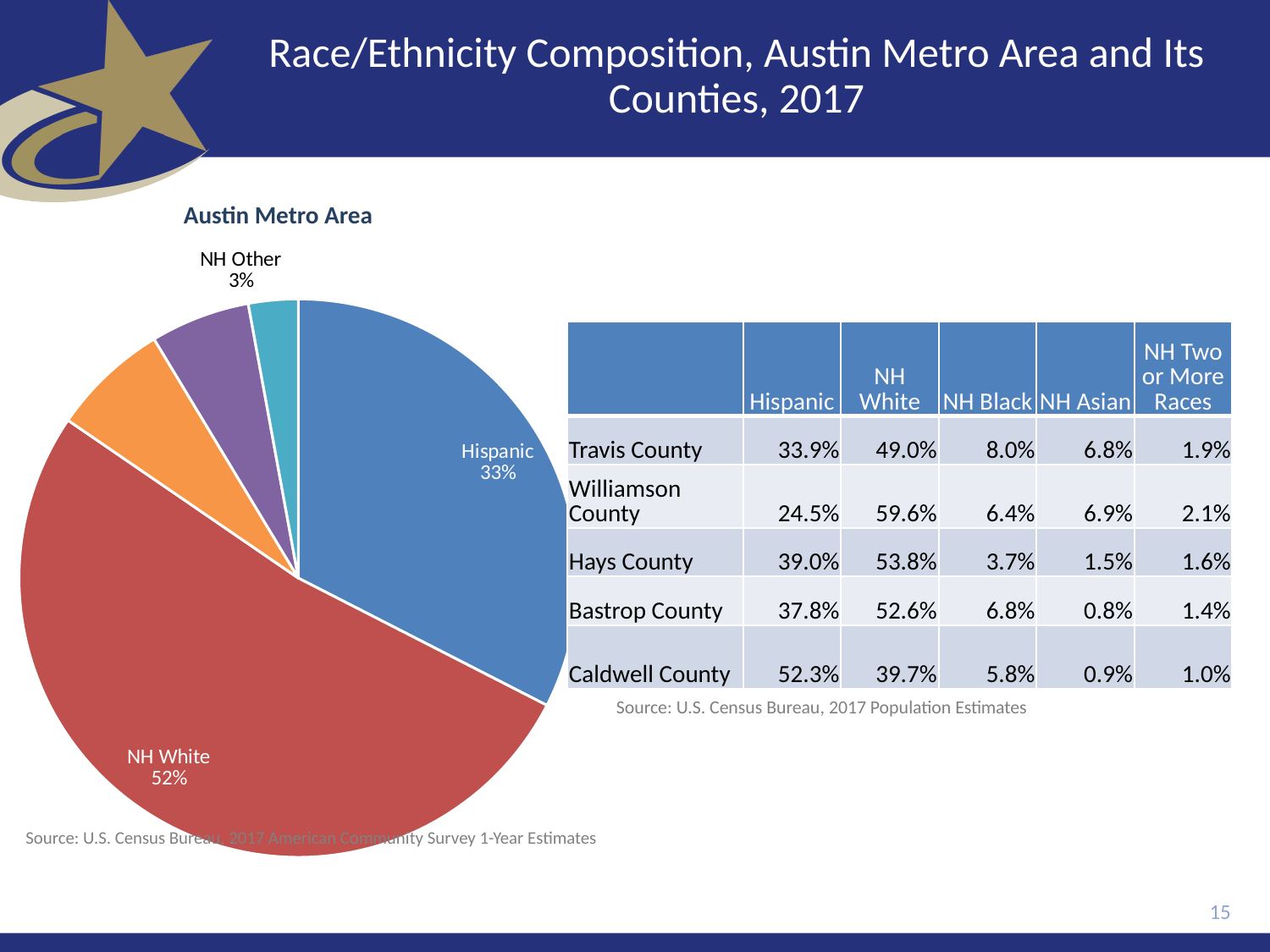
How many slices does the Austin Metro Area pie chart have? 5 What kind of chart is shown for the Austin Metro Area? Pie chart Which labeled group has the smallest slice in the Austin Metro Area pie chart? NH Other What colour is the NH White slice in the Austin Metro Area pie chart? Red In the Austin Metro Area pie chart, how many percentage points larger is the NH White share than the Hispanic share? 19% In the Austin Metro Area pie chart, what share of the population is Hispanic? 33% In the Austin Metro Area pie chart, is the NH White share greater or less than 50%? greater Which group has the largest slice in the Austin Metro Area pie chart? NH White In the Austin Metro Area pie chart, which is larger, the Hispanic slice or the NH White slice? NH White In the Austin Metro Area pie chart, what share of the population is NH White? 52% In the Austin Metro Area pie chart, what share is labeled NH Other? 3% What is the title of the pie chart on the slide? Austin Metro Area